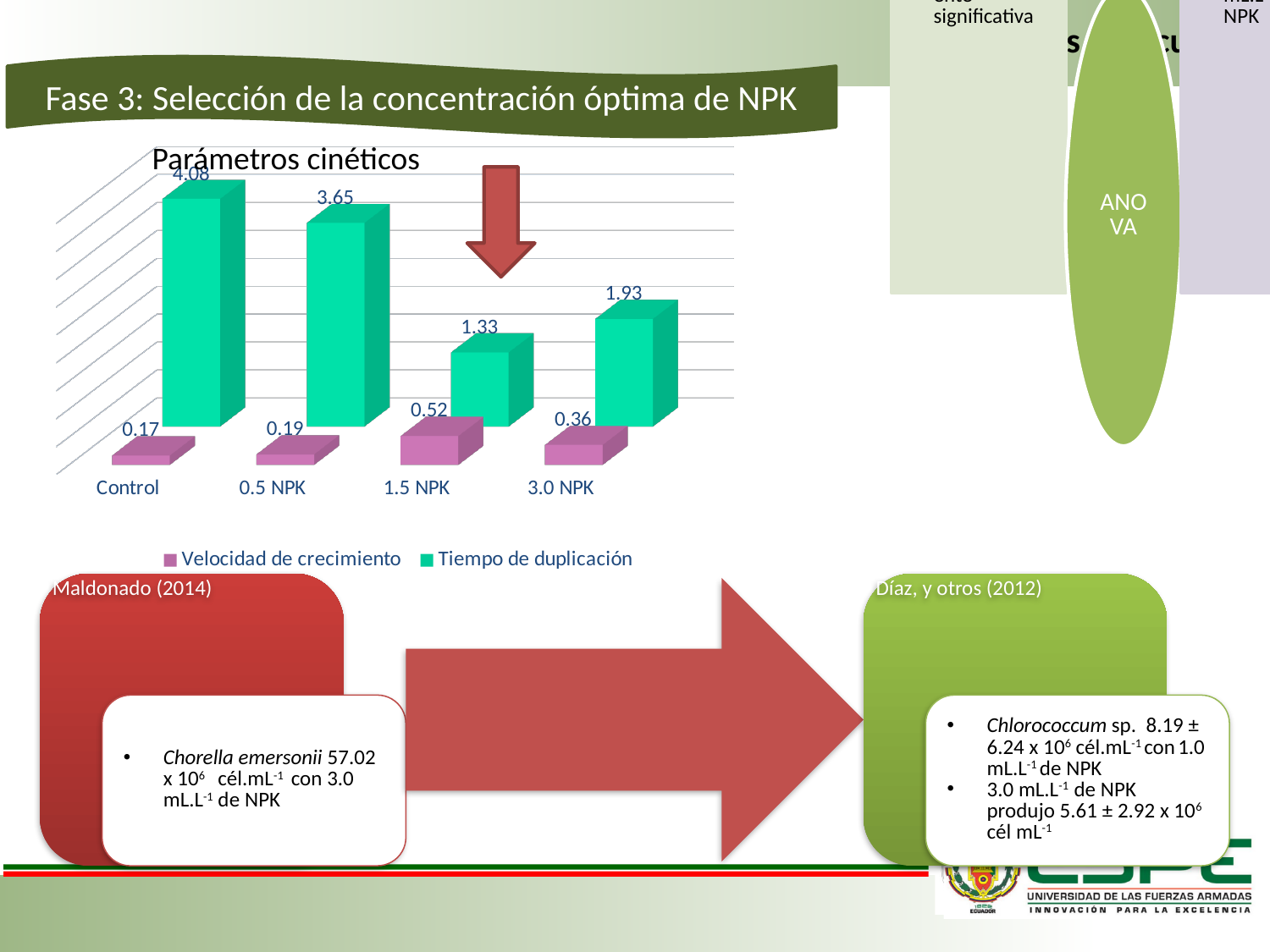
What is the value of 'Tiempo de duplicación' for Control? 4.08 What is the value of 'Tiempo de duplicación' for 3.0 NPK? 1.93 How many series does the legend of the 'Parámetros cinéticos' chart list? 2 How many categories are shown on the x axis of the 'Parámetros cinéticos' chart? 4 Which category has the lowest 'Tiempo de duplicación'? 1.5 NPK Which is larger: 'Velocidad de crecimiento' for 3.0 NPK or for 0.5 NPK? 3.0 NPK Which series is shown in pink in the 'Parámetros cinéticos' chart? Velocidad de crecimiento What is the difference between 'Tiempo de duplicación' for Control and for 0.5 NPK? 0.43 Which category has the highest 'Velocidad de crecimiento'? 1.5 NPK What type of chart is shown under the title 'Parámetros cinéticos'? bar chart What is the value of 'Velocidad de crecimiento' for 1.5 NPK? 0.52 What is the title of the chart on the slide? Parámetros cinéticos